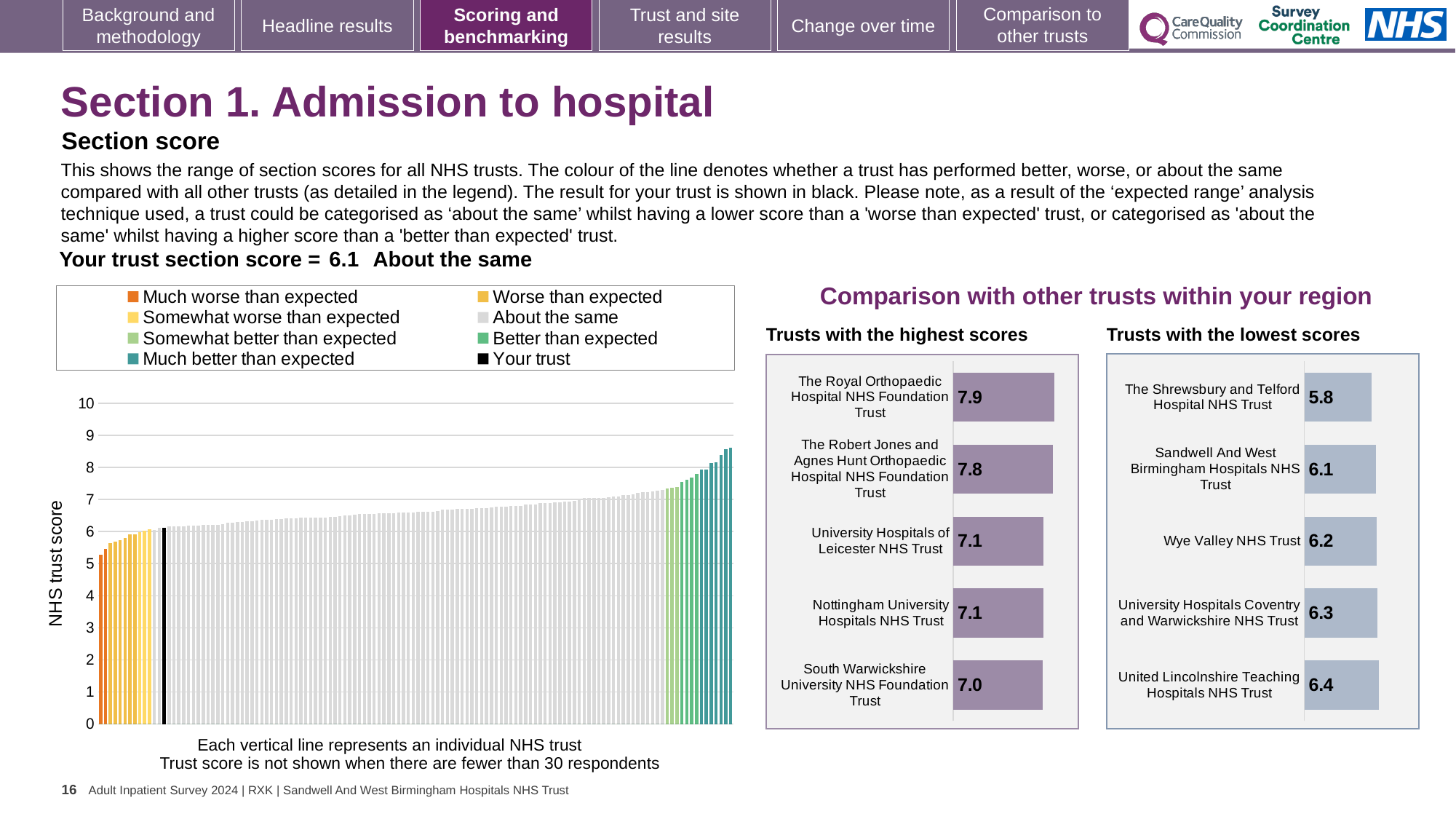
In the 'Trusts with the lowest scores' chart, what is the score for Wye Valley NHS Trust? 6.2 In the 'Trusts with the highest scores' chart, which has a higher score: The Robert Jones and Agnes Hunt Orthopaedic Hospital NHS Foundation Trust or University Hospitals of Leicester NHS Trust? The Robert Jones and Agnes Hunt Orthopaedic Hospital NHS Foundation Trust In the large chart on the left, do the NHS trust scores rise or fall from left to right? Rise What kind of chart is the large chart on the left showing NHS trust scores? Bar chart How many entries does the legend of the large chart on the left list? 8 In the 'Trusts with the highest scores' chart, which trust has the lowest score? South Warwickshire University NHS Foundation Trust In the 'Trusts with the highest scores' chart, what is the score for The Royal Orthopaedic Hospital NHS Foundation Trust? 7.9 In the 'Trusts with the lowest scores' chart, what is the difference between the scores of United Lincolnshire Teaching Hospitals NHS Trust and The Shrewsbury and Telford Hospital NHS Trust? 0.6 In the 'Trusts with the highest scores' chart, what is the difference between the scores of The Royal Orthopaedic Hospital NHS Foundation Trust and South Warwickshire University NHS Foundation Trust? 0.9 In the 'Trusts with the lowest scores' chart, which trust has the lowest score? The Shrewsbury and Telford Hospital NHS Trust How many trusts are listed in the 'Trusts with the lowest scores' chart? 5 In the 'Trusts with the lowest scores' chart, which trust has the highest score? United Lincolnshire Teaching Hospitals NHS Trust